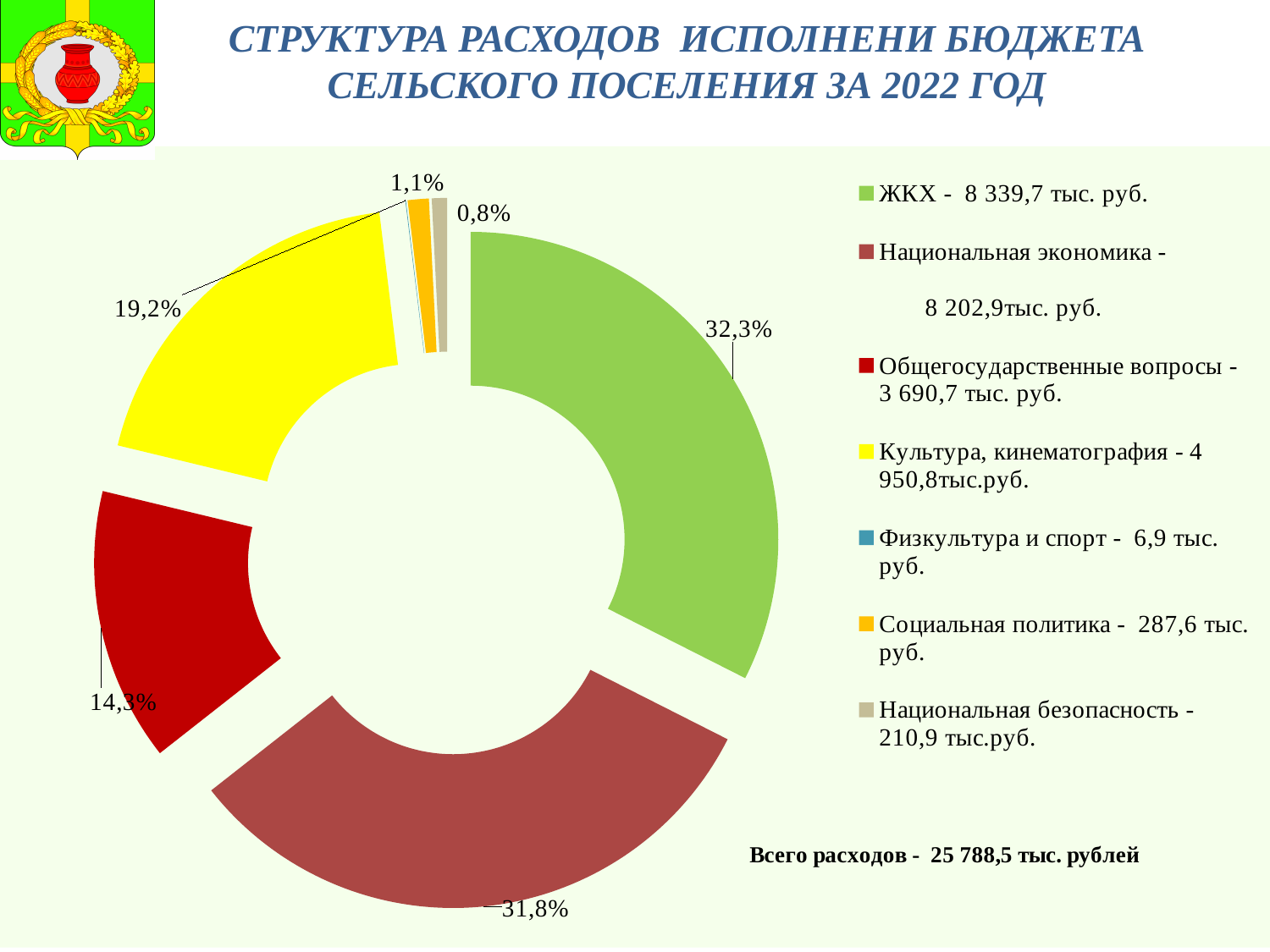
Which category has the largest slice in the doughnut chart? ЖКХ How many categories does the legend list? 7 What share of the doughnut chart does Национальная безопасность take? 0,8% Which slice is larger: Культура, кинематография or Общегосударственные вопросы? Культура, кинематография According to the legend, what is the amount for Общегосударственные вопросы? 3 690,7 тыс. руб. What kind of chart is shown on the slide? Doughnut (pie) chart According to the legend, what is the amount for Социальная политика? 287,6 тыс. руб. What total expenditure is stated on the slide? 25 788,5 тыс. рублей Which category has the smallest slice in the doughnut chart? Физкультура и спорт What share of the doughnut chart does Культура, кинематография take? 19,2% What share of the doughnut chart does Национальная экономика take? 31,8%